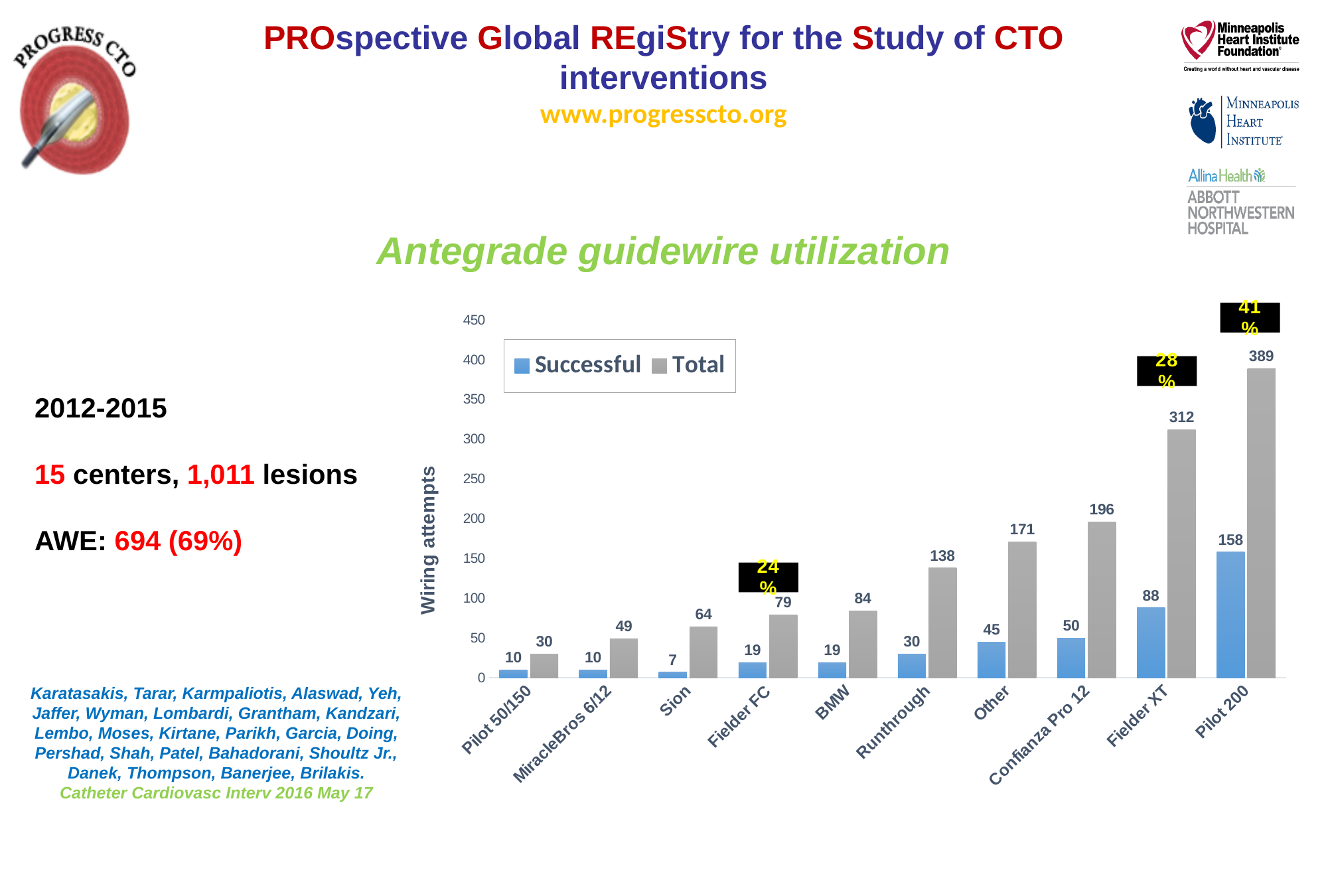
Which is larger, the Total value for Other or the Total value for BMW? Other How many categories are shown on the x axis? 10 What is the Total value for Pilot 200? 389 Do the Total values generally rise or fall from left to right along the x axis? Rise Which category has the lowest Successful value? Sion Which category has the highest Total value? Pilot 200 How many series does the legend list? 2 What is the label of the y axis? Wiring attempts What kind of chart is shown on the slide? Bar chart What is the Total value for Runthrough? 138 What is the Successful value for Fielder XT? 88 What is the difference between the Total and Successful values for Confianza Pro 12? 146